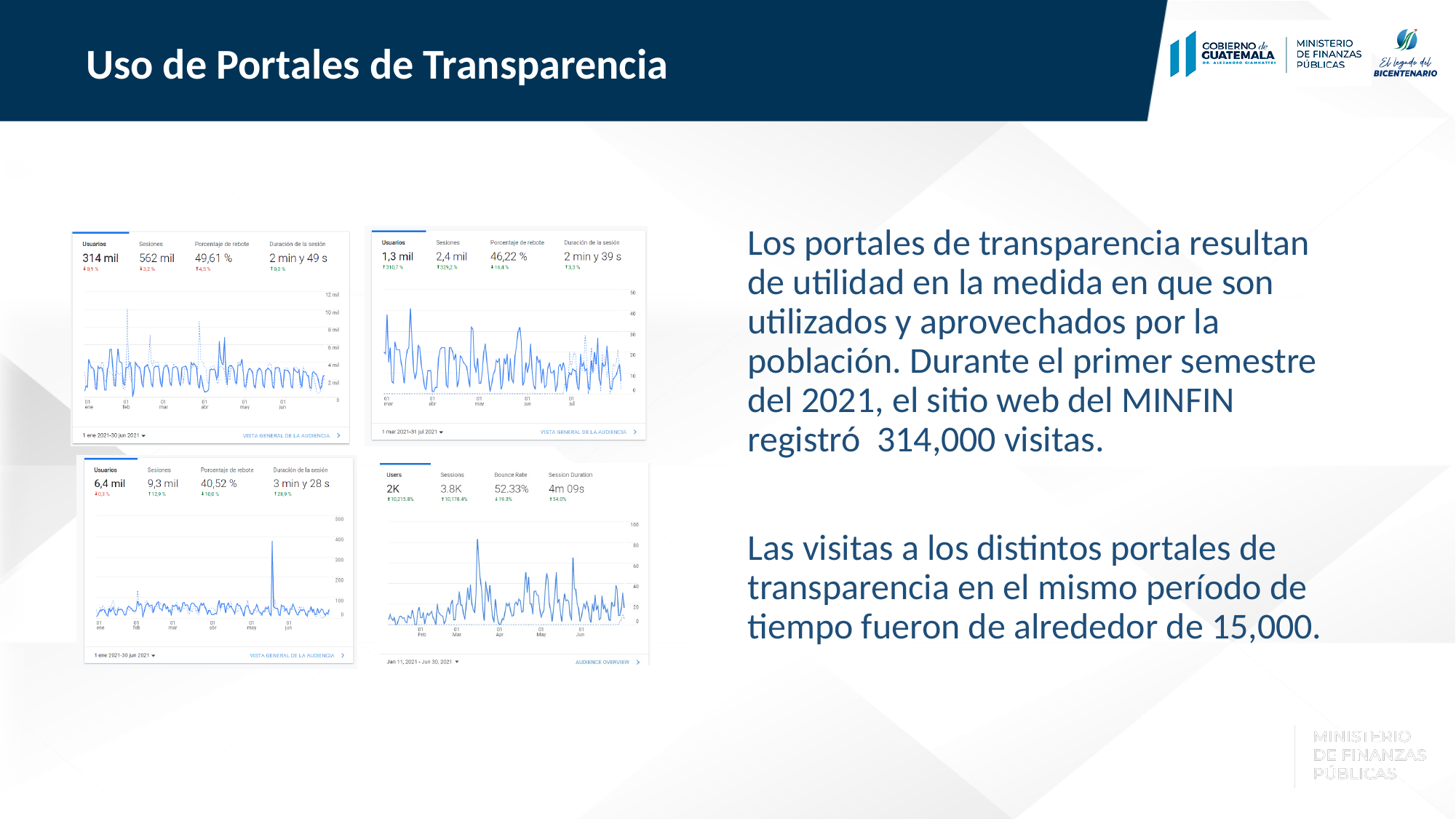
In the top-left chart, what is the Porcentaje de rebote? 49,61 % In the bottom-left chart, what is the Duración de la sesión? 3 min y 28 s What kind of chart is shown in each of the four analytics panels? line chart In the bottom-left chart, what is the value shown for Usuarios? 6,4 mil In the top-left chart, what is the value shown for Sesiones? 562 mil In the top-right chart, what is the Duración de la sesión? 2 min y 39 s In the top-left chart, what is the value shown for Usuarios? 314 mil In the bottom-right chart, what is the Bounce Rate? 52.33% In the bottom-left chart, is the highest spike in the line greater or less than 300? greater In the bottom-right chart, what is the value shown for Sessions? 3.8K Which has the higher bounce rate, the top-left chart (49,61 %) or the bottom-left chart (40,52 %)? top-left chart What date range is shown at the bottom of the top-right chart? 1 mar 2021–31 jul 2021